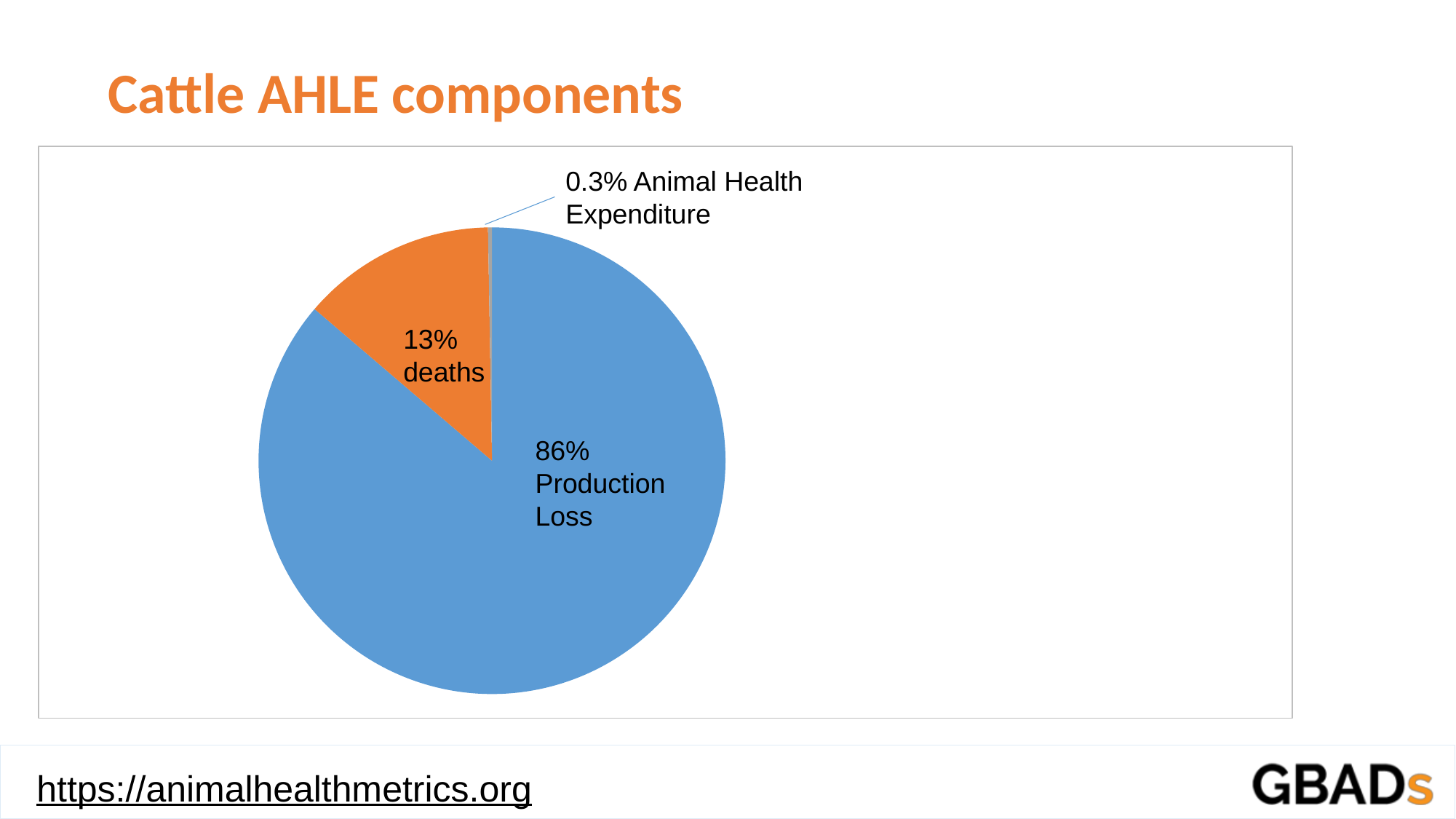
Which is larger, the share for deaths or the share for Animal Health Expenditure? deaths What share of the pie does Production Loss represent? 86% What is the difference in percentage points between the Production Loss share and the deaths share? 73 percentage points How many slices does the pie chart have? 3 What is the title of the chart? Cattle AHLE components What colour is the Production Loss slice? blue Which component has the smallest share of the pie? Animal Health Expenditure Which component has the largest share of the pie? Production Loss What share of the pie does Animal Health Expenditure represent? 0.3% What share of the pie does deaths represent? 13% What kind of chart is shown on the slide? pie chart